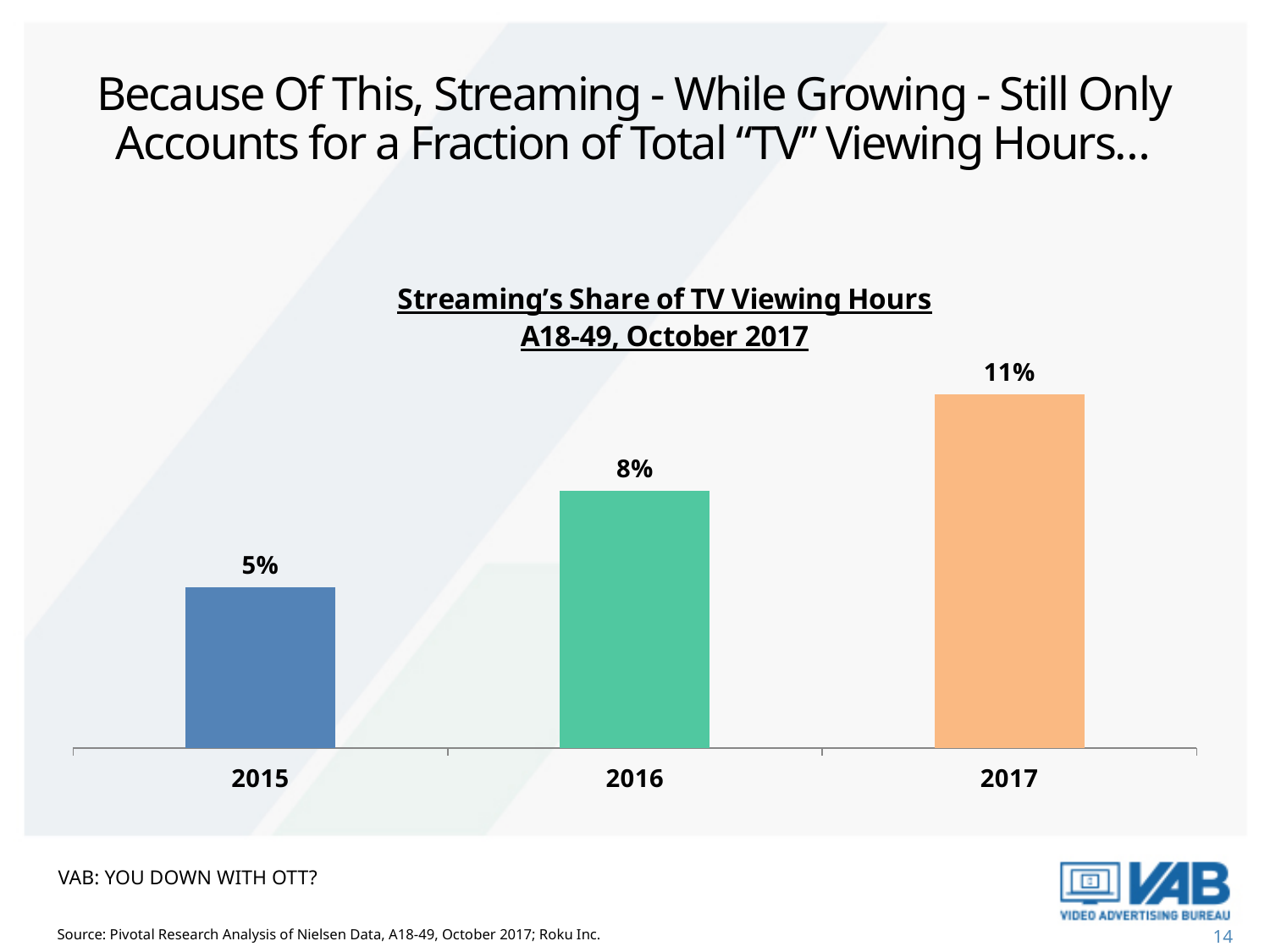
What is the title of the chart? Streaming's Share of TV Viewing Hours A18-49, October 2017 Which year has the highest streaming share of TV viewing hours? 2017 What is the difference between the 2016 and 2015 streaming share values? 3 percentage points By how many percentage points did streaming's share of TV viewing hours increase from 2015 to 2017? 6 percentage points Does streaming's share of TV viewing hours rise or fall from 2015 to 2017? Rise Which year has the lowest streaming share of TV viewing hours? 2015 What is streaming's share of TV viewing hours in 2017? 11% What type of chart is shown on the slide? Bar chart How many years are shown on the chart? 3 What is streaming's share of TV viewing hours in 2016? 8% What is streaming's share of TV viewing hours in 2015? 5% Which is larger, the streaming share in 2016 or in 2017? 2017